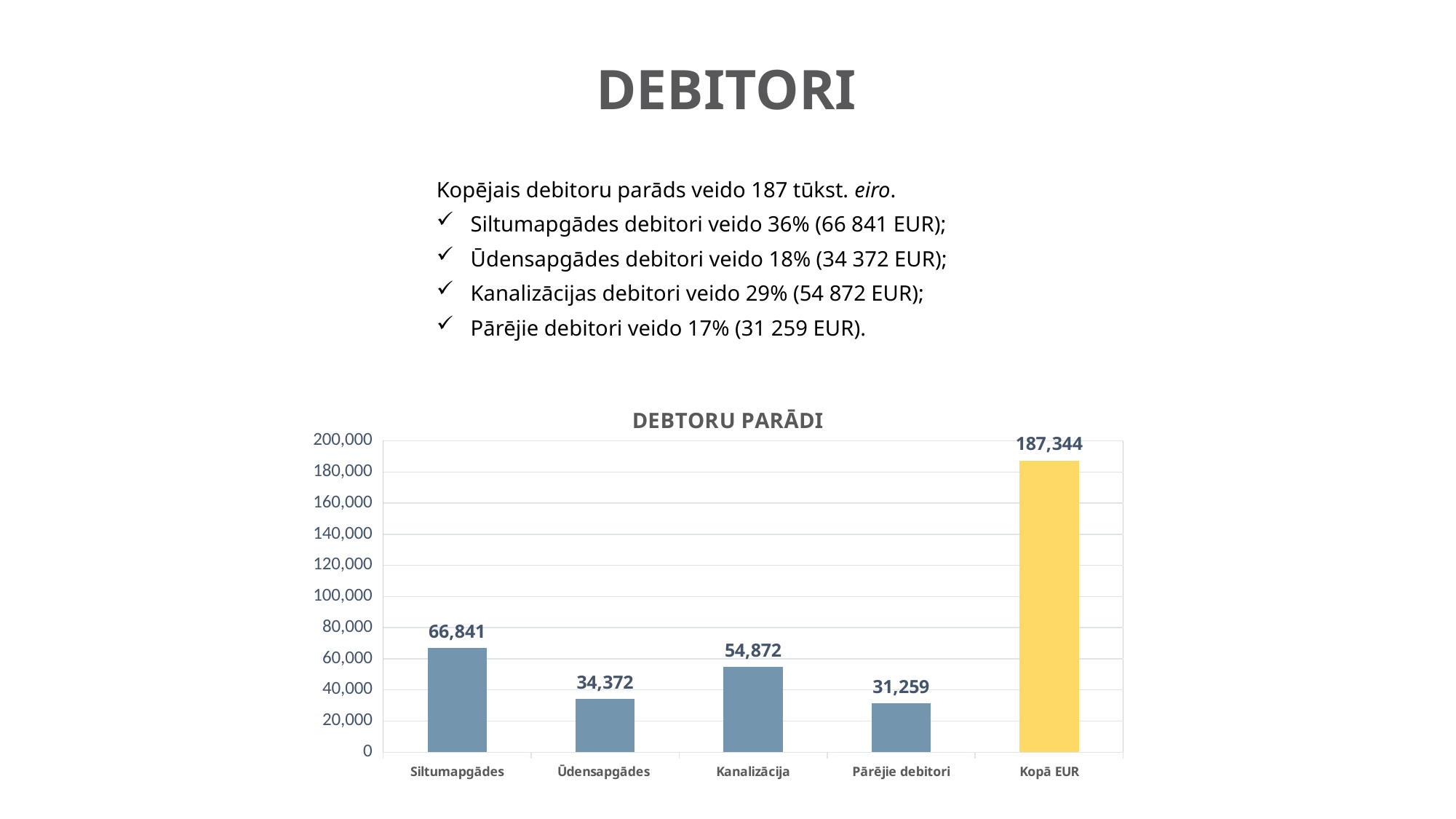
What is the value for Kopā EUR in the chart? 187,344 Which category has the lowest value in the chart? Pārējie debitori What is the difference between the values for Siltumapgādes and Kanalizācija? 11,969 Which category has the highest value in the chart? Kopā EUR What is the value for Ūdensapgādes in the chart? 34,372 What type of chart is shown on the slide? bar chart Is the value for Siltumapgādes greater or less than 60,000? greater How many categories are shown on the x axis of the chart? 5 What is the value for Kanalizācija in the chart? 54,872 What is the value for Siltumapgādes in the chart? 66,841 Which is larger, the value for Ūdensapgādes or the value for Kanalizācija? Kanalizācija What is the value for Pārējie debitori in the chart? 31,259